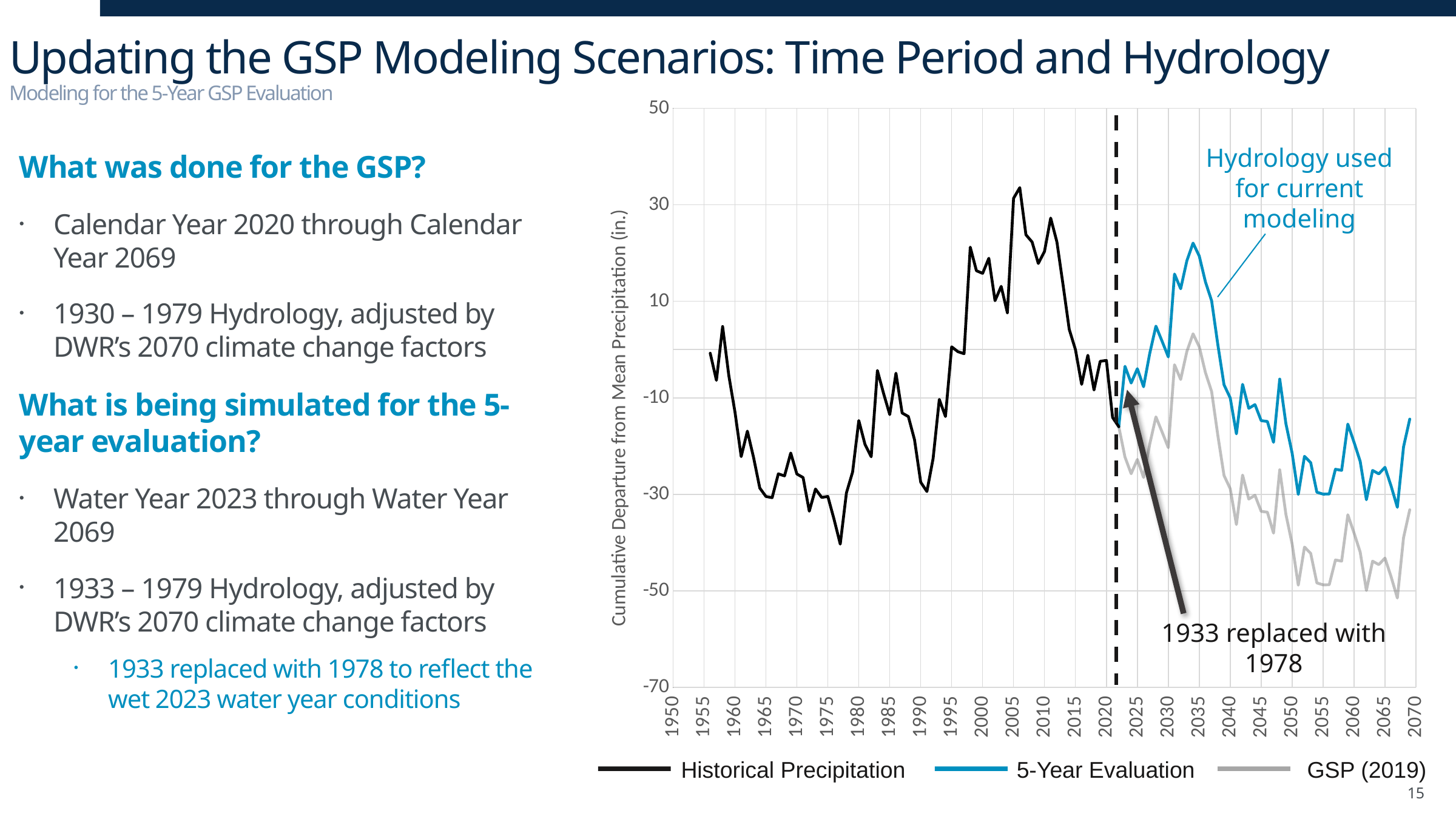
What is the title of the chart's vertical axis? Cumulative Departure from Mean Precipitation (in.) Around 2060, which series has the higher value: 5-Year Evaluation or GSP (2019)? 5-Year Evaluation Is the peak value of the 5-Year Evaluation line around 2034 greater or less than 10? greater Does the GSP (2019) line rise or fall between 2035 and 2055? Fall What kind of chart is shown on the slide? Line chart Is the peak value of the Historical Precipitation line around 2005 greater or less than 30? greater Is the lowest value of the Historical Precipitation line around 1977 greater or less than -30? less Which series in the chart is drawn in blue? 5-Year Evaluation How many series does the chart legend list? 3 Does the Historical Precipitation line rise or fall between 1990 and 2005? Rise